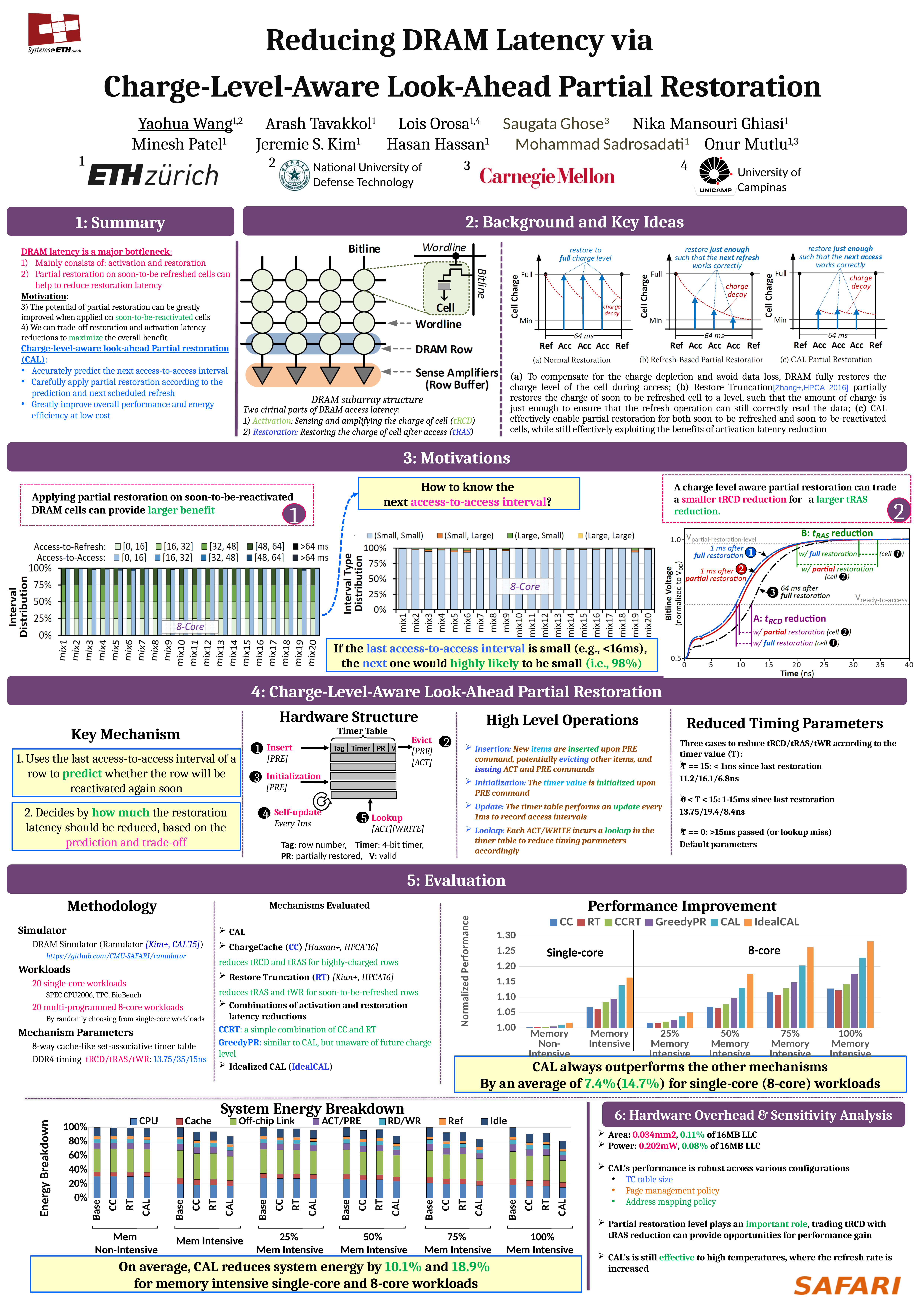
In the System Energy Breakdown chart, how many bars are shown within each workload group? 4 In the Performance Improvement chart, is the IdealCAL value for 100% Memory Intensive greater or less than 1.25? greater In the Performance Improvement chart, is the CAL value for the single-core Memory Intensive workloads greater or less than 1.10? greater In the System Energy Breakdown chart, how many series does the legend list? 7 In the Performance Improvement chart, which is larger for the 100% Memory Intensive workloads: CAL or CC? CAL In the Interval Type Distribution chart, which interval type makes up the largest share of the bars? (Small, Small) In the Performance Improvement chart, how many series does the legend list? 6 In the Performance Improvement chart, which mechanism has the highest normalized performance for the 100% Memory Intensive workloads? IdealCAL In the Interval Type Distribution chart, how many mix workloads are shown on the x axis? 20 In the Performance Improvement chart, which workload group has the highest IdealCAL value? 100% Memory Intensive What kind of chart is the System Energy Breakdown chart? stacked bar chart In the Performance Improvement chart, is the CC value for the Memory Non-Intensive workloads greater or less than 1.05? less